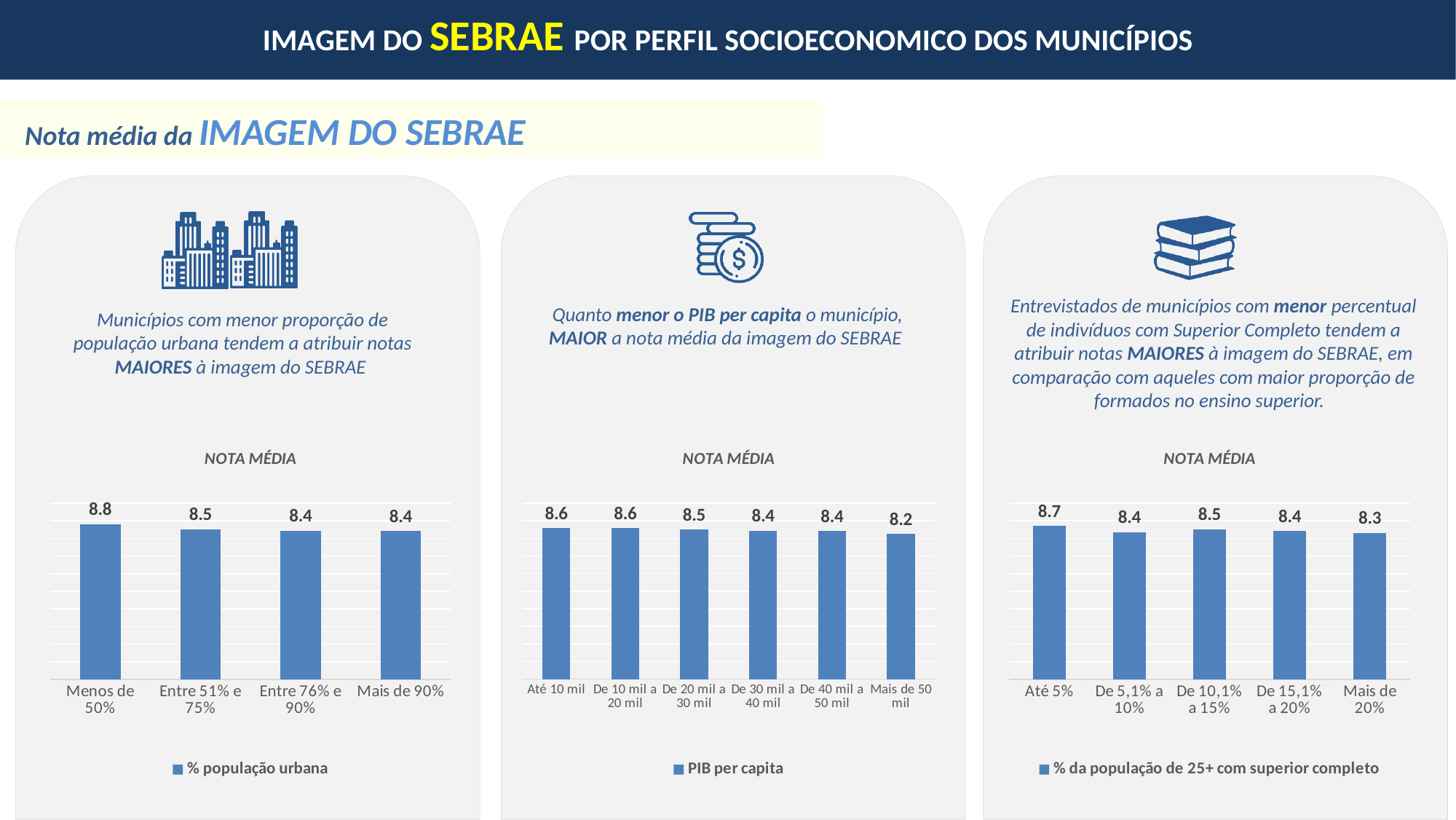
How many categories are shown in the middle chart (PIB per capita)? 6 In the middle chart (PIB per capita), do the values generally rise or fall from left to right? fall In the left chart (% população urbana), what is the value for 'Menos de 50%'? 8.8 In the left chart (% população urbana), which category has the highest value? Menos de 50% How many categories are shown in the left chart (% população urbana)? 4 In the middle chart (PIB per capita), what is the value for 'Mais de 50 mil'? 8.2 What type of chart is the right chart (% da população de 25+ com superior completo)? bar chart In the left chart (% população urbana), what is the difference between 'Menos de 50%' and 'Mais de 90%'? 0.4 In the middle chart (PIB per capita), which category has the lowest value? Mais de 50 mil In the right chart (% da população de 25+ com superior completo), what is the value for 'Até 5%'? 8.7 In the right chart (% da população de 25+ com superior completo), which is larger: 'De 10,1% a 15%' or 'Mais de 20%'? De 10,1% a 15% In the right chart (% da população de 25+ com superior completo), what is the difference between 'Até 5%' and 'Mais de 20%'? 0.4